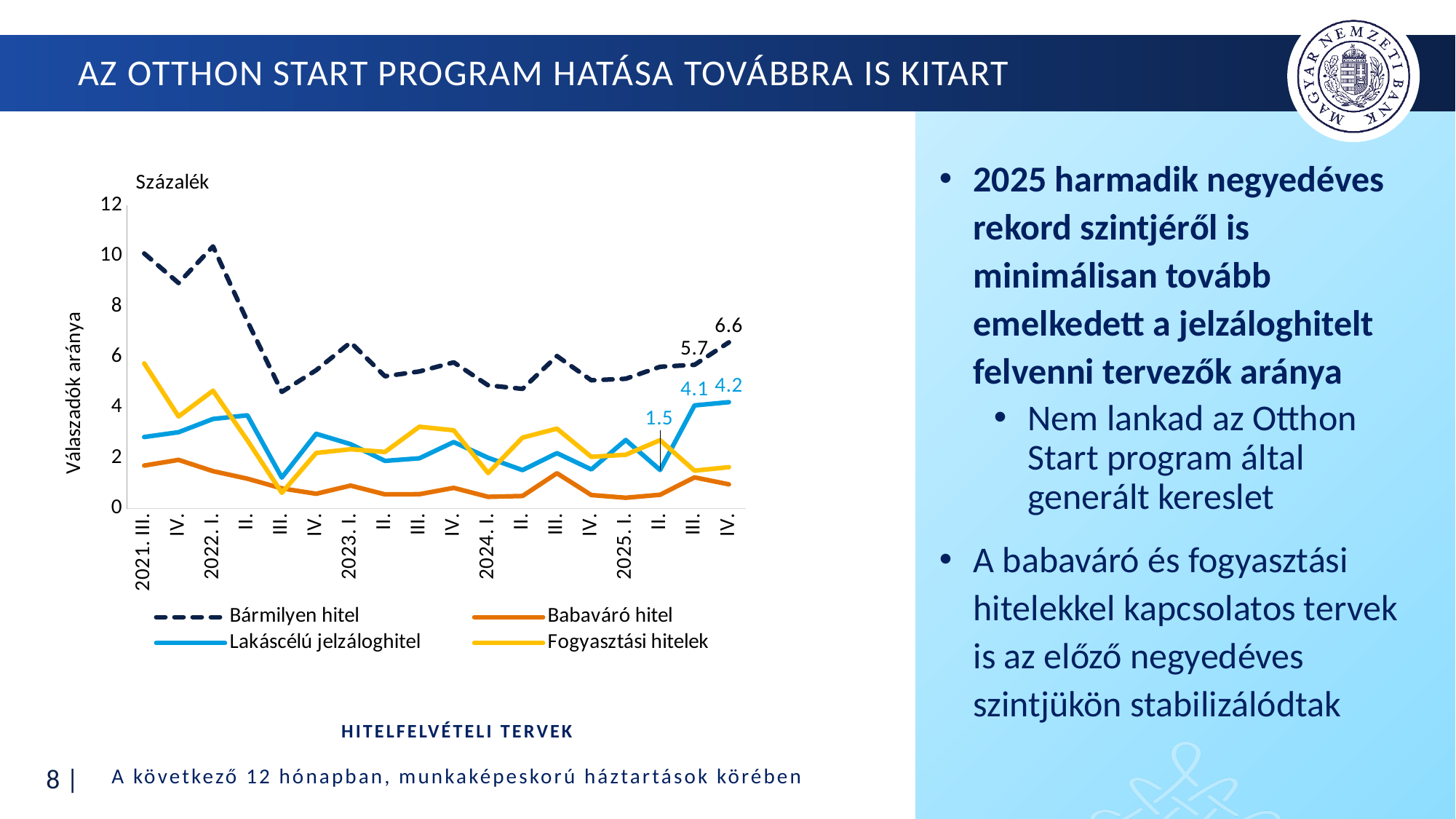
What is the value of Lakáscélú jelzáloghitel for 2025. III.? 4.1 What is the value of Bármilyen hitel for 2025. IV.? 6.6 Is the value of Bármilyen hitel for 2021. III. greater or less than 8? greater What is the title of the chart? HITELFELVÉTELI TERVEK What kind of chart is shown on the slide? line chart Is the value of Fogyasztási hitelek for 2021. III. greater or less than 4? greater How many series does the legend of the chart list? 4 By how much did Lakáscélú jelzáloghitel increase from 2025. II. to 2025. IV.? 2.7 What is the difference between the Bármilyen hitel values for 2025. IV. and 2025. III.? 0.9 What is the value of Lakáscélú jelzáloghitel for 2025. II.? 1.5 At 2025. IV., which is larger: Bármilyen hitel or Lakáscélú jelzáloghitel? Bármilyen hitel Which series has the lowest value at 2025. IV.? Babaváró hitel